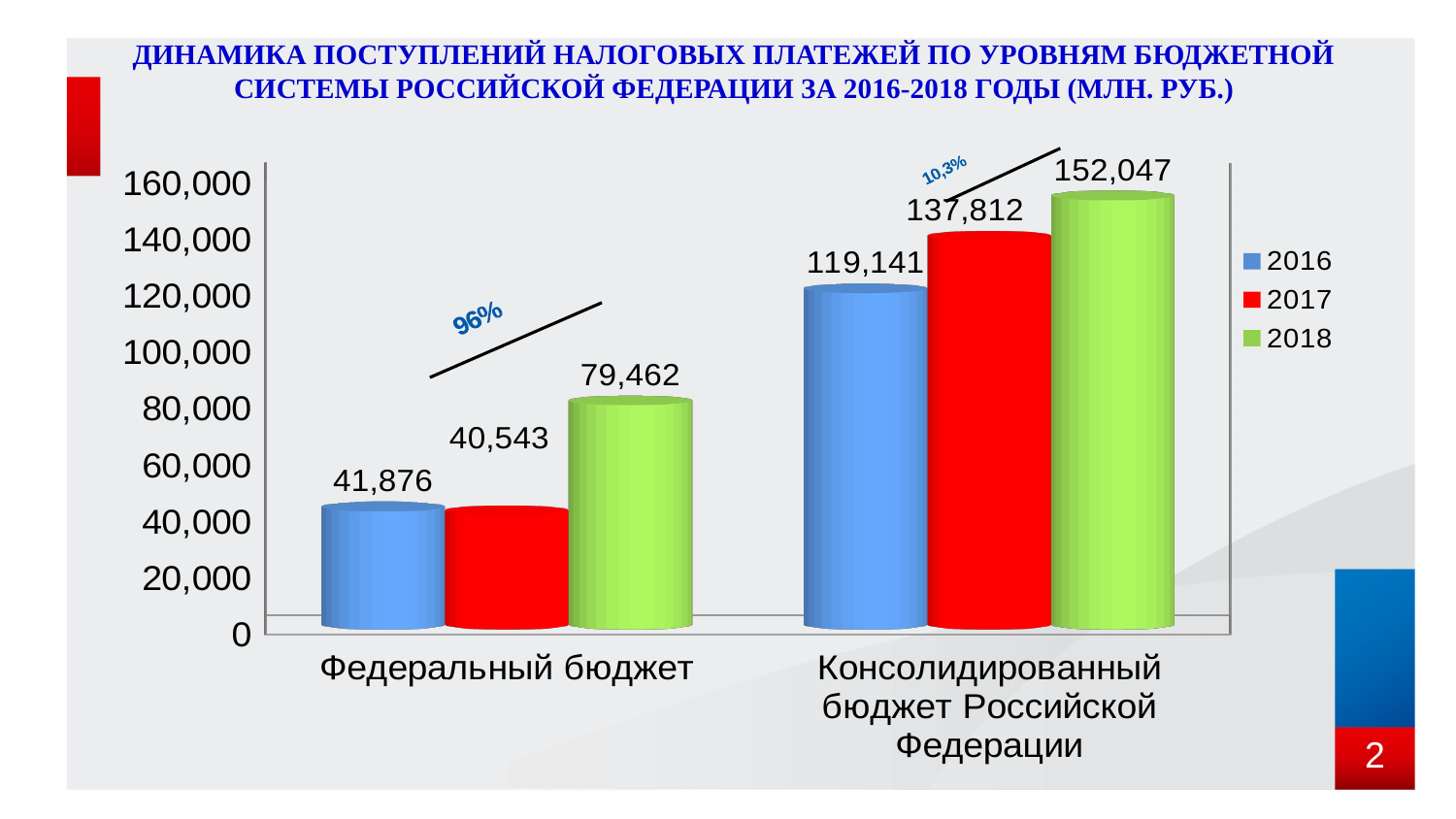
What is the value for 2018 in the Федеральный бюджет category? 79,462 Which colour represents the 2017 series in the legend? red What is the difference between the 2018 and 2017 values in the Консолидированный бюджет Российской Федерации category? 14,235 Is the 2017 value for Консолидированный бюджет Российской Федерации greater or less than 120,000? greater What is the value for 2016 in the Консолидированный бюджет Российской Федерации category? 119,141 How many categories are shown on the x axis? 2 How many series does the legend list? 3 Which year has the highest value in the Консолидированный бюджет Российской Федерации category? 2018 What is the value for 2017 in the Федеральный бюджет category? 40,543 Which is larger: the 2016 value for Федеральный бюджет or the 2016 value for Консолидированный бюджет Российской Федерации? Консолидированный бюджет Российской Федерации Which year has the lowest value in the Федеральный бюджет category? 2017 What kind of chart is shown on the slide? bar chart